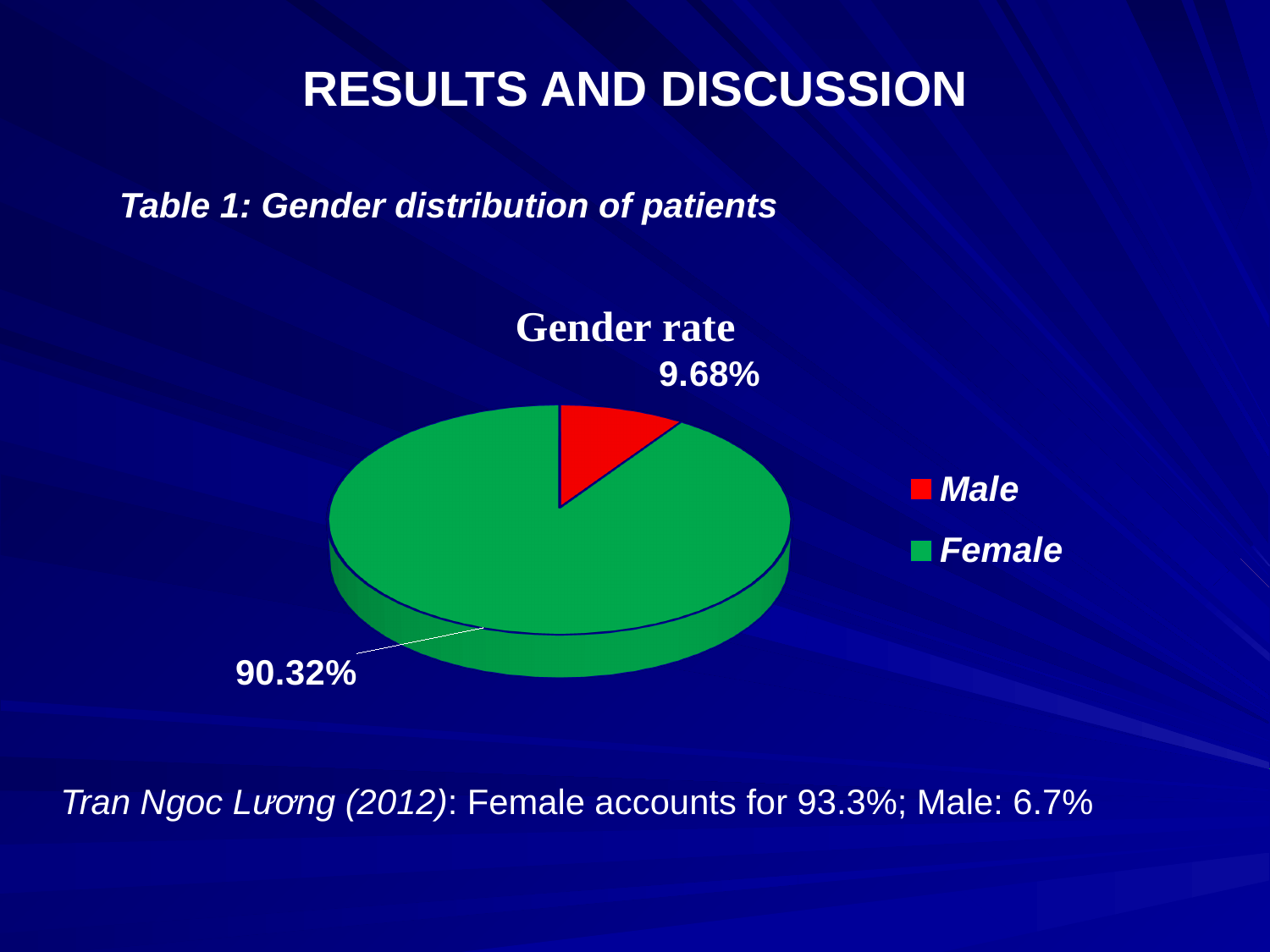
Which is larger, the Male share or the Female share? Female Which gender has the largest share of the pie? Female How many slices does the pie chart have? 2 What percentage of patients are Female according to the chart? 90.32% What is the total of the two slices shown in the pie chart? 100% Which gender has the smallest share of the pie? Male What percentage of patients are Male according to the chart? 9.68% How many entries does the legend list? 2 What type of chart is shown on the slide? Pie chart What is the title of the chart? Gender rate What colour represents Male in the chart? Red What is the difference in percentage points between the Female and Male shares? 80.64